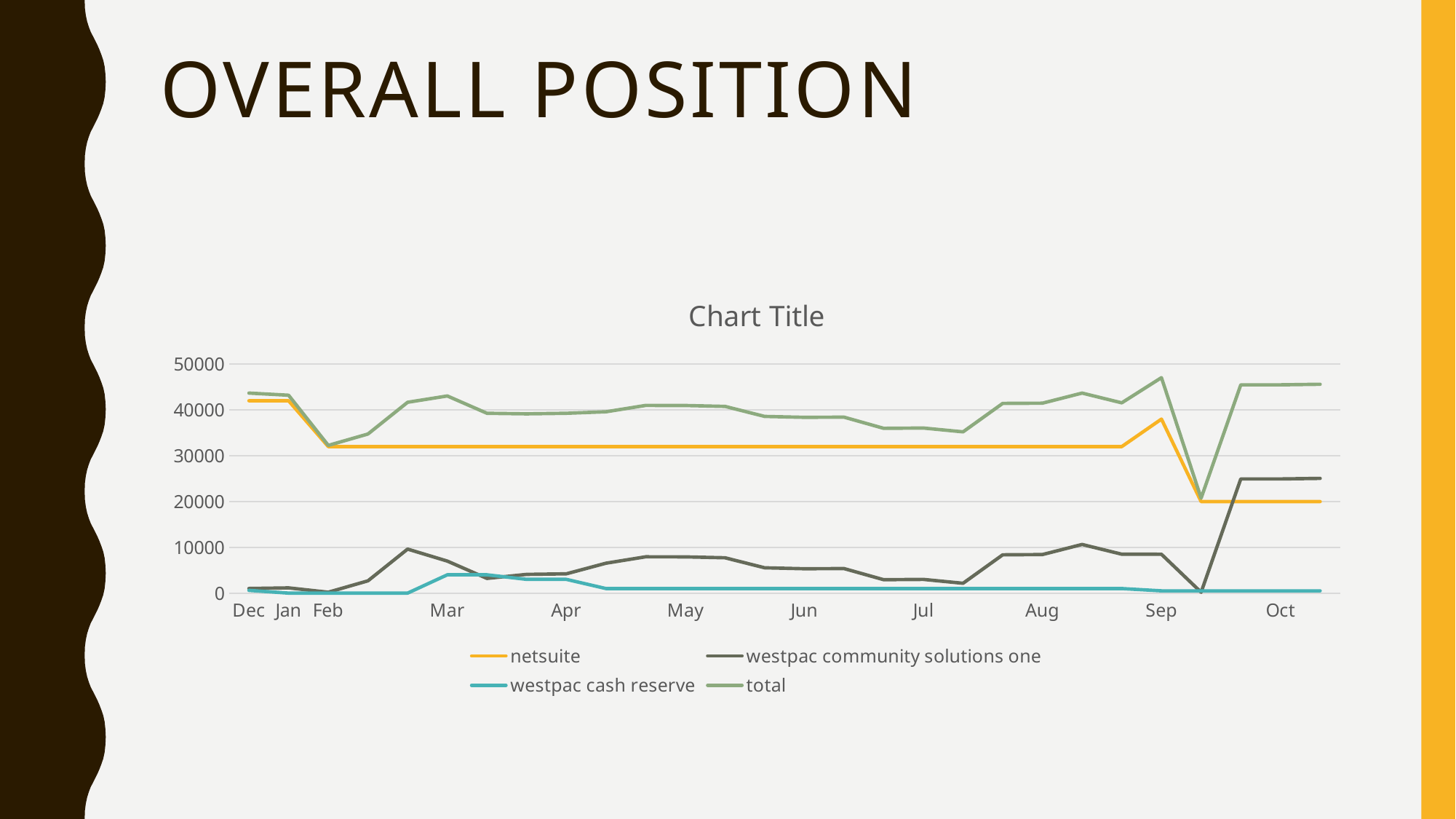
How many series does the legend list? 4 Does the netsuite line rise or fall overall from Dec to Oct? fall What is the title shown above the chart? Chart Title In Dec, which is larger: netsuite or westpac cash reserve? netsuite In Oct, which is larger: netsuite or westpac community solutions one? westpac community solutions one Is the value for westpac community solutions one in Oct greater or less than 20000? greater What kind of chart is shown on the slide? line chart Is the value for total in Oct greater or less than 40000? greater Is the value for netsuite in May greater or less than 30000? greater Which series has the highest value in Oct? total How many month labels are shown on the x axis? 11